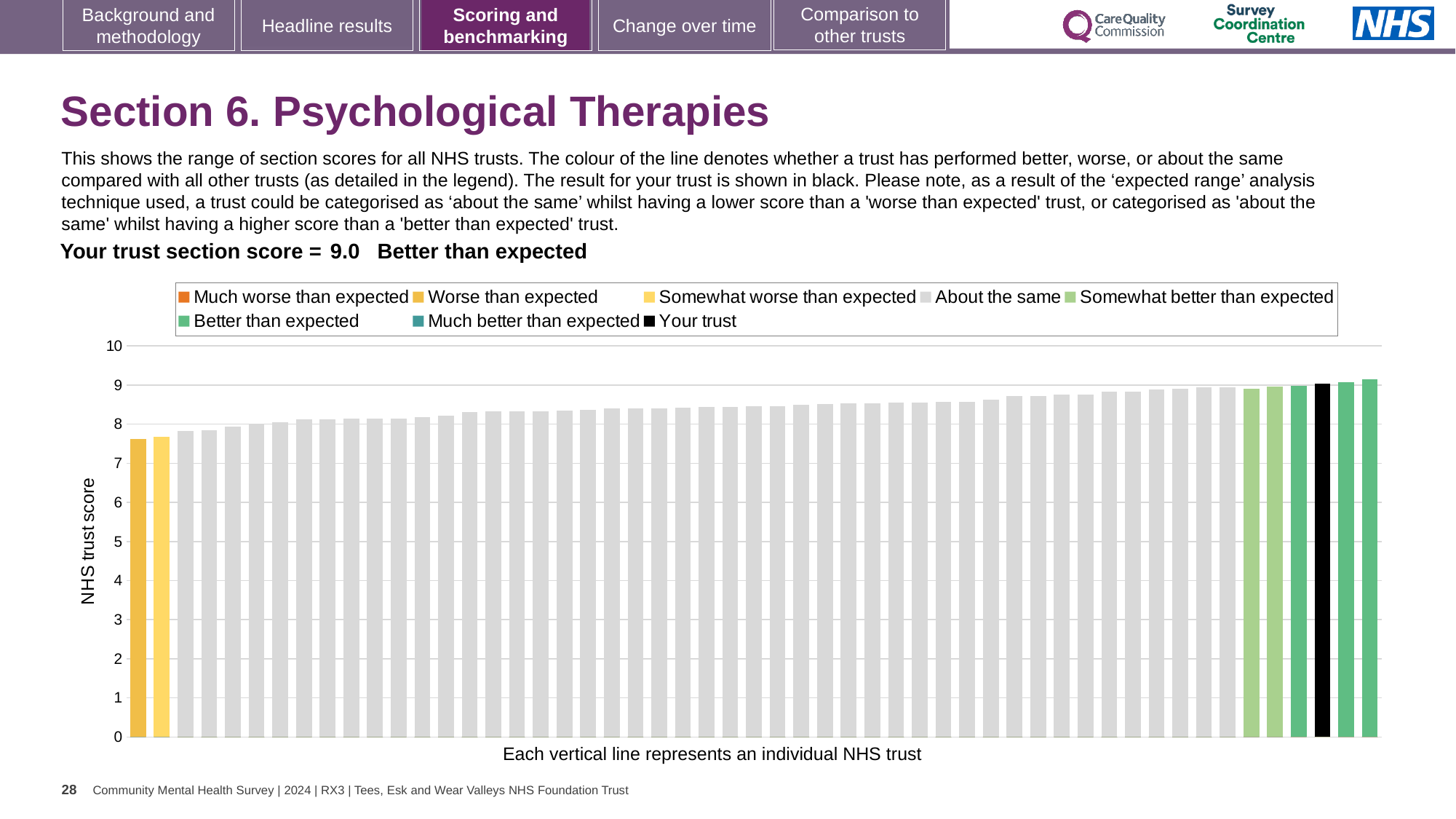
What colour is the bar representing your trust? black How many entries does the chart legend list? 8 Do the bar values rise or fall from left to right along the x axis? rise Is the value for the black 'Your trust' bar greater or less than 8? greater Is the value for the leftmost bar greater or less than 7? greater Is the value for the rightmost bar greater or less than 10? less What kind of chart is shown on the slide? bar chart Which is larger, the black 'Your trust' bar or the leftmost bar? the black 'Your trust' bar What is the label on the vertical axis of the chart? NHS trust score Which performance category is your trust assigned for this section? Better than expected What is the section score for your trust shown on the slide? 9.0